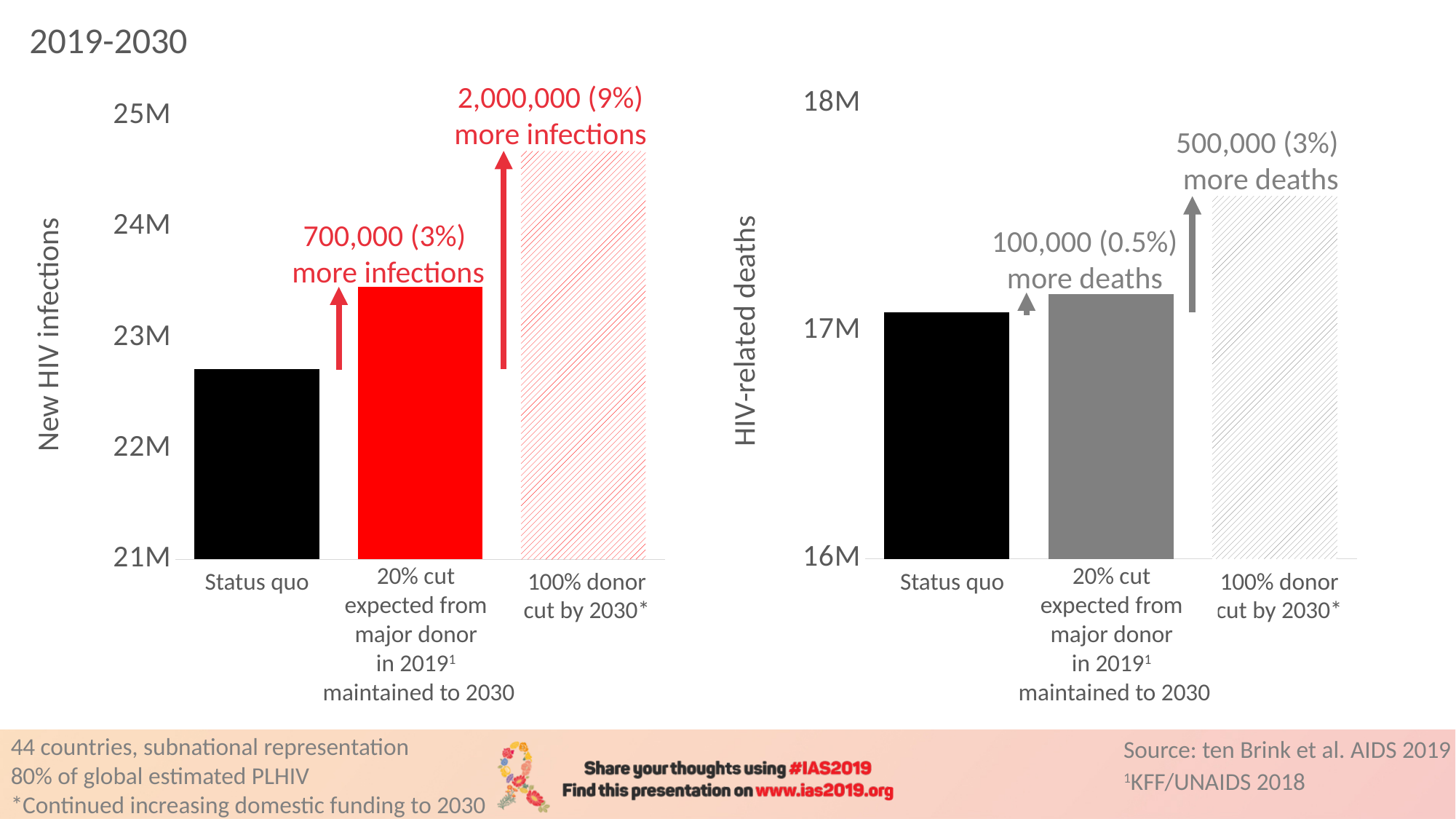
On the HIV-related deaths chart, how many more deaths are annotated for the 100% donor cut by 2030 scenario? 500,000 (3%) On the New HIV infections chart, how many more infections are annotated for the 20% cut scenario compared with the status quo? 700,000 (3%) On the New HIV infections chart, is the value for the 100% donor cut by 2030 scenario greater or less than 24M? greater On the HIV-related deaths chart, how many more deaths are annotated for the 20% cut scenario? 100,000 (0.5%) On the HIV-related deaths chart, is the value for the 100% donor cut by 2030 scenario greater or less than 18M? less On the New HIV infections chart, which scenario has the highest bar? 100% donor cut by 2030 On the New HIV infections chart, how many more infections are annotated for the 100% donor cut by 2030 scenario? 2,000,000 (9%) On the New HIV infections chart, is the value for Status quo greater or less than 23M? less What kind of chart is the HIV-related deaths chart? Bar chart On the HIV-related deaths chart, which scenario has the lowest bar? Status quo How many scenarios (categories) are shown on the New HIV infections chart? 3 On the HIV-related deaths chart, which is larger: the bar for Status quo or the bar for 100% donor cut by 2030? 100% donor cut by 2030